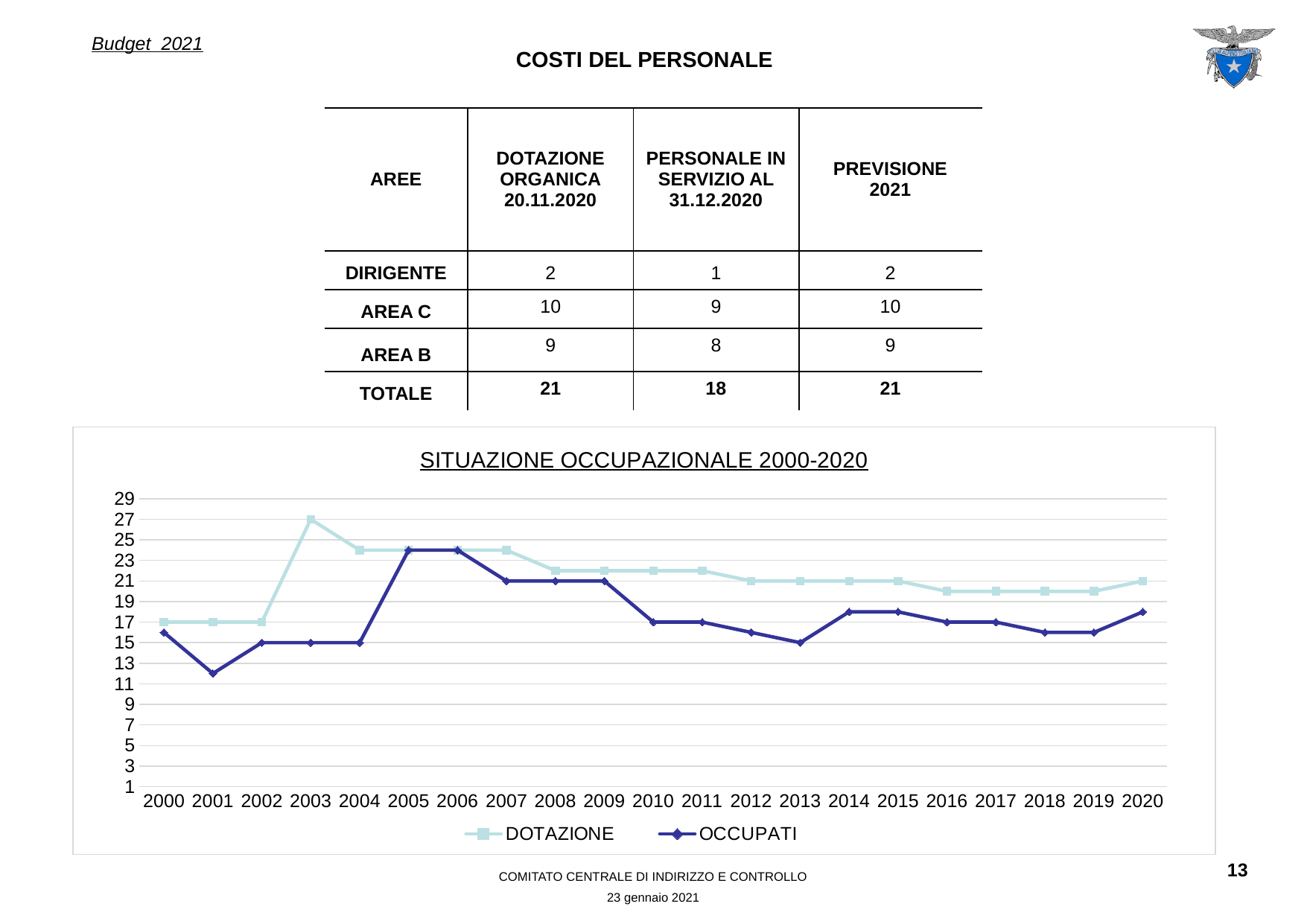
What is the DOTAZIONE value in 2003? 27 In 2003, which series has the larger value, DOTAZIONE or OCCUPATI? DOTAZIONE What is the title of the chart? SITUAZIONE OCCUPAZIONALE 2000-2020 What kind of chart is shown on the slide? line chart Is the DOTAZIONE value for 2004 greater or less than 23? greater How many series does the chart legend list? 2 Is the OCCUPATI value for 2001 greater or less than 13? less What is the OCCUPATI value in 2013? 15 How many years are plotted along the x axis of the chart? 21 What is the DOTAZIONE value in 2000? 17 In which year does the DOTAZIONE series reach its highest value? 2003 In which year is the OCCUPATI series at its lowest? 2001